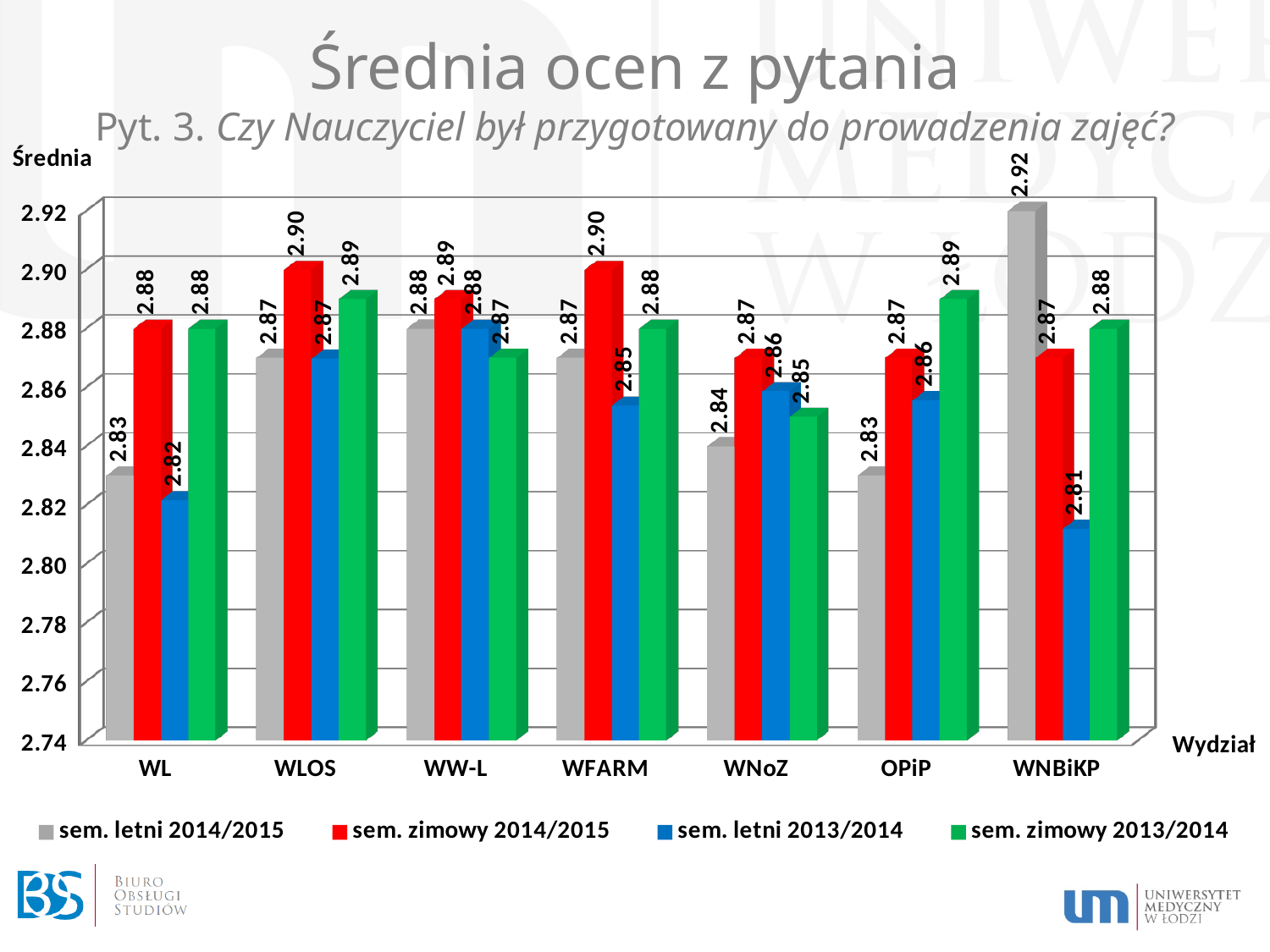
What kind of chart is shown on the slide? bar chart For WFARM, which is larger: the sem. zimowy 2014/2015 value or the sem. letni 2013/2014 value? sem. zimowy 2014/2015 Which category has the lowest value in the sem. letni 2013/2014 series? WNBiKP What is the difference between the sem. letni 2014/2015 and sem. letni 2013/2014 values for WNBiKP? 0.11 How many categories (faculties) are shown on the x axis? 7 What is the value for WL in the sem. letni 2013/2014 series? 2.82 What is the difference between the sem. zimowy 2014/2015 and sem. letni 2014/2015 values for WL? 0.05 What is the label of the vertical axis? Średnia Which category has the highest value in the sem. letni 2014/2015 series? WNBiKP What is the value for WNBiKP in the sem. letni 2014/2015 series? 2.92 How many series does the legend list? 4 What is the value for OPiP in the sem. zimowy 2013/2014 series? 2.89